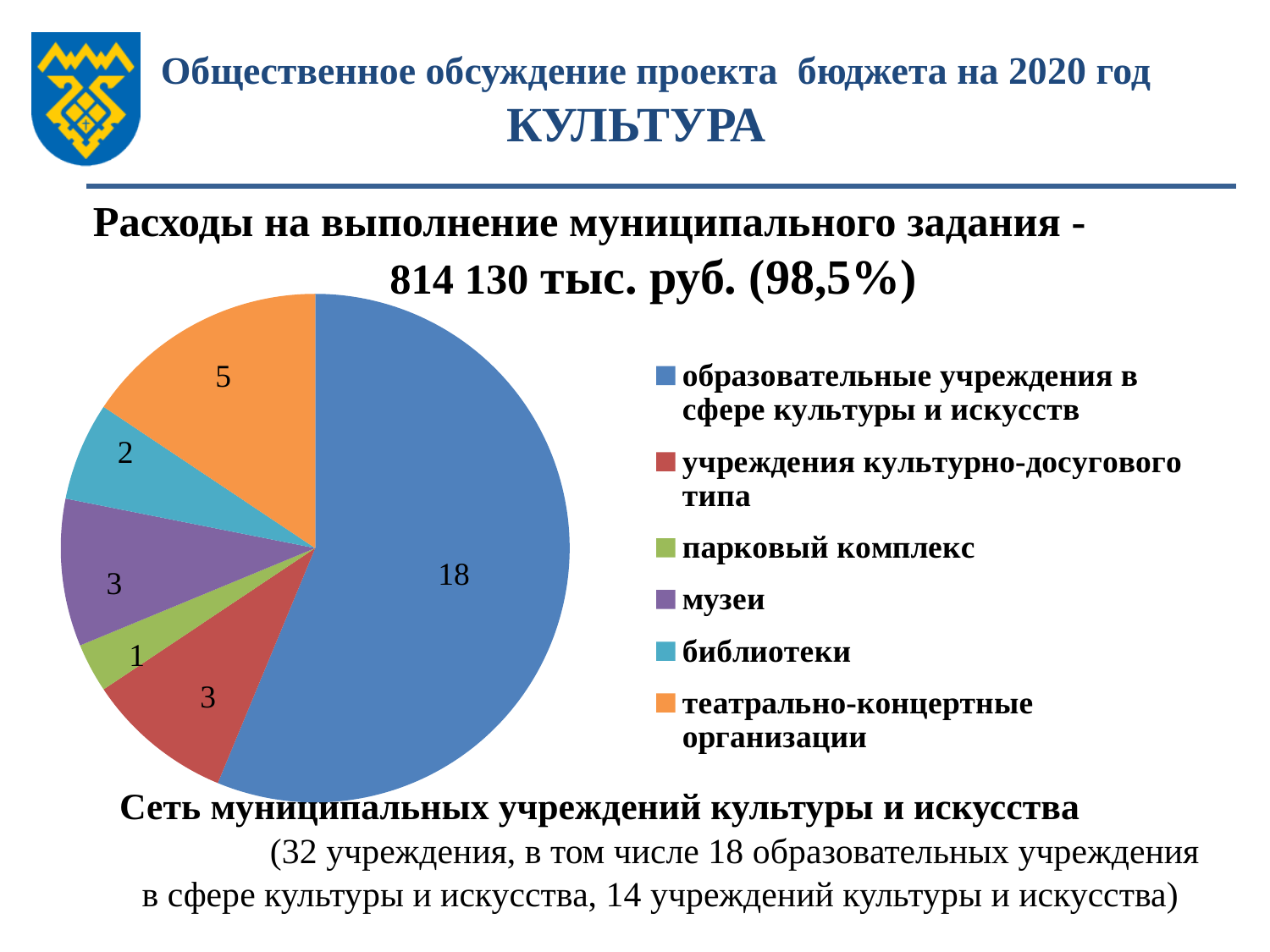
What is the value for образовательные учреждения в сфере культуры и искусств? 18 Which category has the largest slice of the pie? образовательные учреждения в сфере культуры и искусств Which category has the smallest slice of the pie? парковый комплекс What kind of chart is shown on the slide? pie chart What is the value for парковый комплекс? 1 Which is larger, the value for музеи or the value for библиотеки? музеи What is the value for театрально-концертные организации? 5 What is the total of all the values in the pie chart? 32 What is the value for библиотеки? 2 How many categories does the pie chart have? 6 What colour is the slice for театрально-концертные организации? orange What is the difference between the value for образовательные учреждения в сфере культуры и искусств and the value for театрально-концертные организации? 13